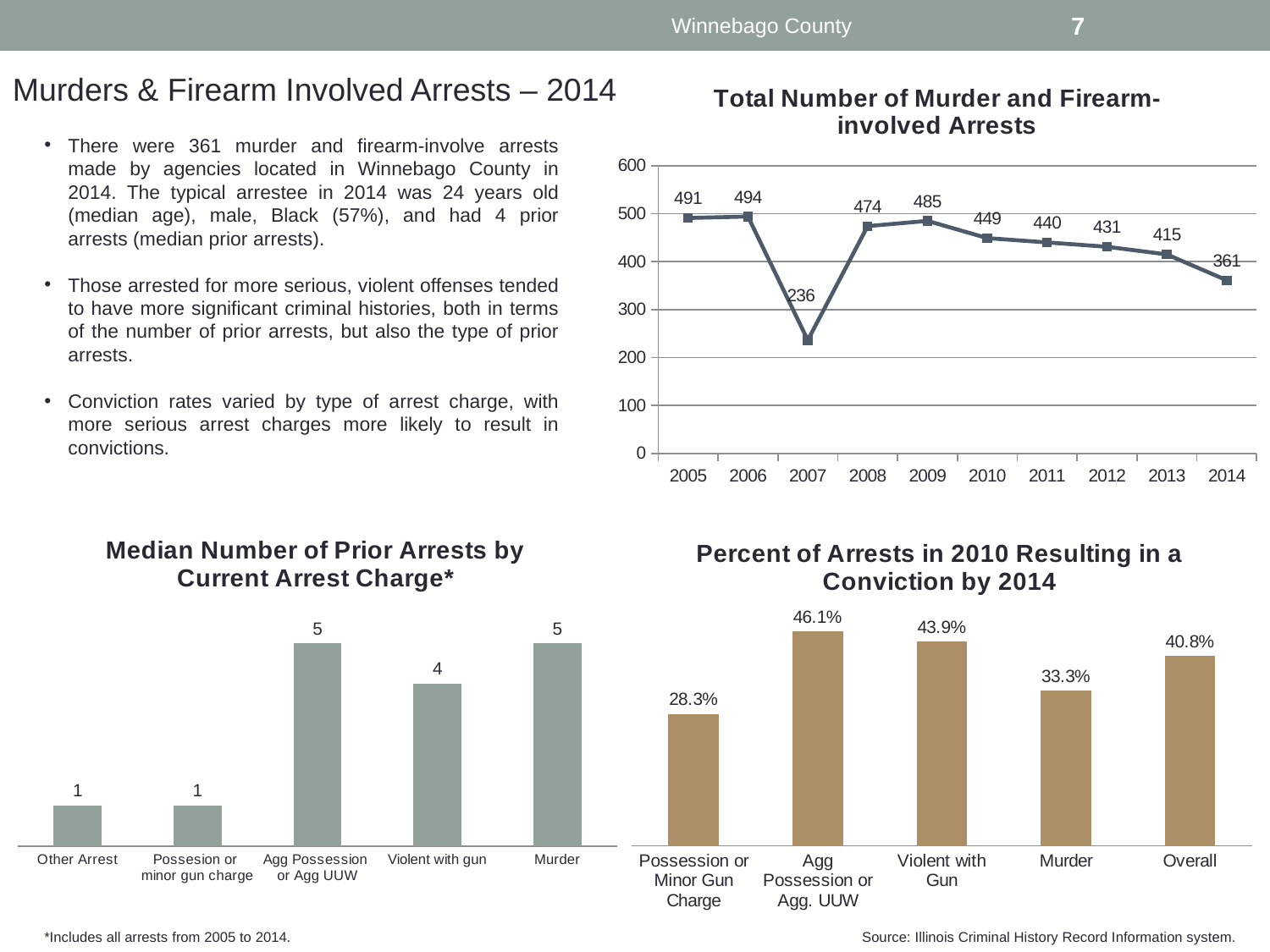
In the 'Median Number of Prior Arrests by Current Arrest Charge' chart, how many categories are shown? 5 In the 'Percent of Arrests in 2010 Resulting in a Conviction by 2014' chart, which is larger: Violent with Gun or Overall? Violent with Gun In the 'Percent of Arrests in 2010 Resulting in a Conviction by 2014' chart, which category has the highest value? Agg Possession or Agg. UUW What kind of chart is the 'Total Number of Murder and Firearm-involved Arrests' chart? Line chart In the 'Total Number of Murder and Firearm-involved Arrests' chart, what is the difference between the 2013 and 2014 values? 54 In the 'Percent of Arrests in 2010 Resulting in a Conviction by 2014' chart, what is the value for Murder? 33.3% In the 'Median Number of Prior Arrests by Current Arrest Charge' chart, what is the value for Violent with gun? 4 In the 'Total Number of Murder and Firearm-involved Arrests' chart, which year has the highest value? 2006 In the 'Total Number of Murder and Firearm-involved Arrests' chart, which year has the lowest value? 2007 In the 'Total Number of Murder and Firearm-involved Arrests' chart, how many years are plotted? 10 In the 'Total Number of Murder and Firearm-involved Arrests' chart, what is the value for 2007? 236 In the 'Total Number of Murder and Firearm-involved Arrests' chart, do the values generally rise or fall from 2009 to 2014? Fall